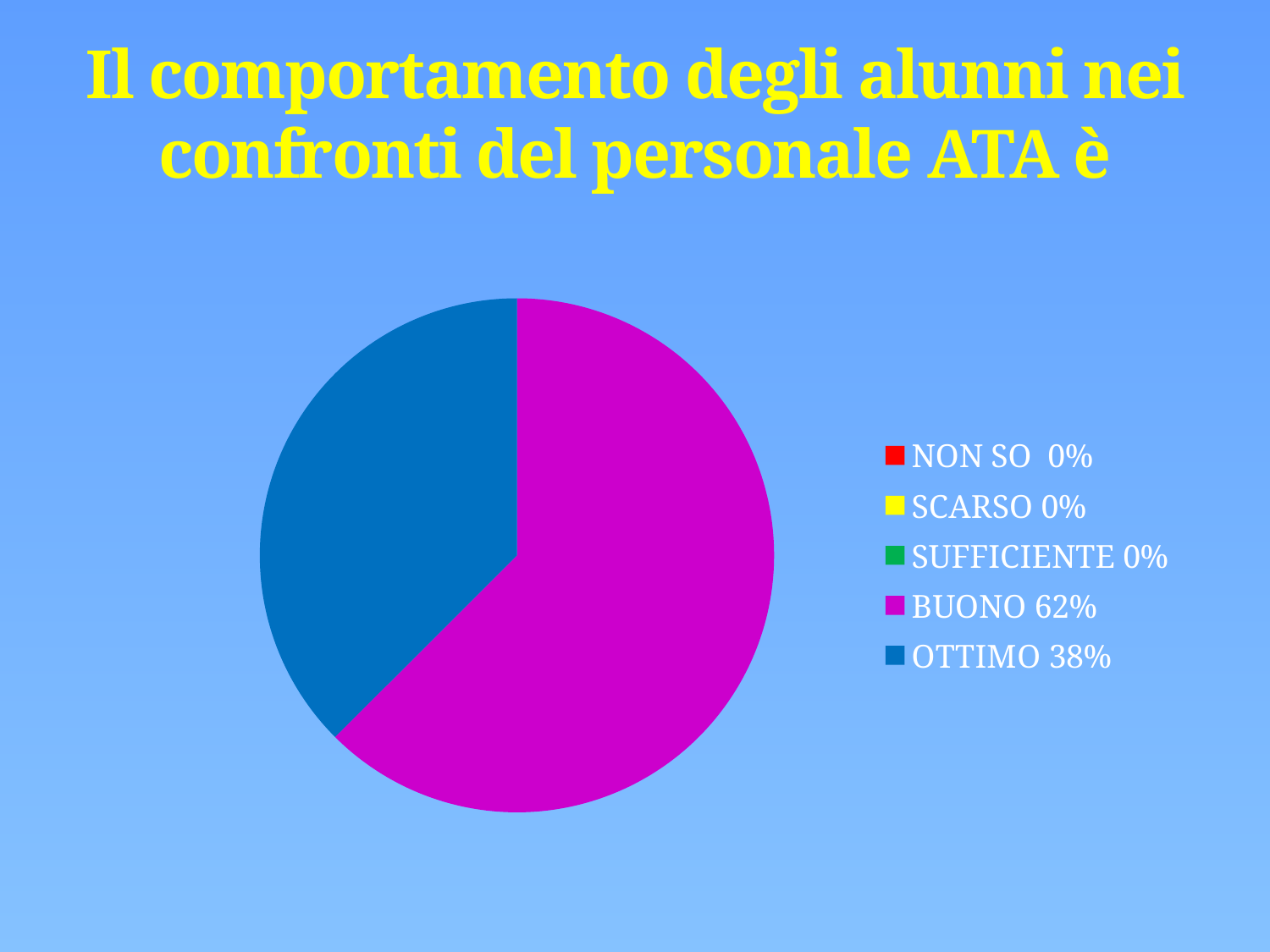
Which category has the largest share of the pie? BUONO Which is larger, the share for BUONO or the share for OTTIMO? BUONO What colour is the OTTIMO slice? blue What is the difference between the BUONO and OTTIMO shares? 24% How many categories does the legend list? 5 What is the value for NON SO? 0% What is the value for SCARSO? 0% What kind of chart is shown on the slide? pie chart What is the title of the slide? Il comportamento degli alunni nei confronti del personale ATA è What is the value for SUFFICIENTE? 0% What share of the pie does BUONO represent? 62% What share of the pie does OTTIMO represent? 38%